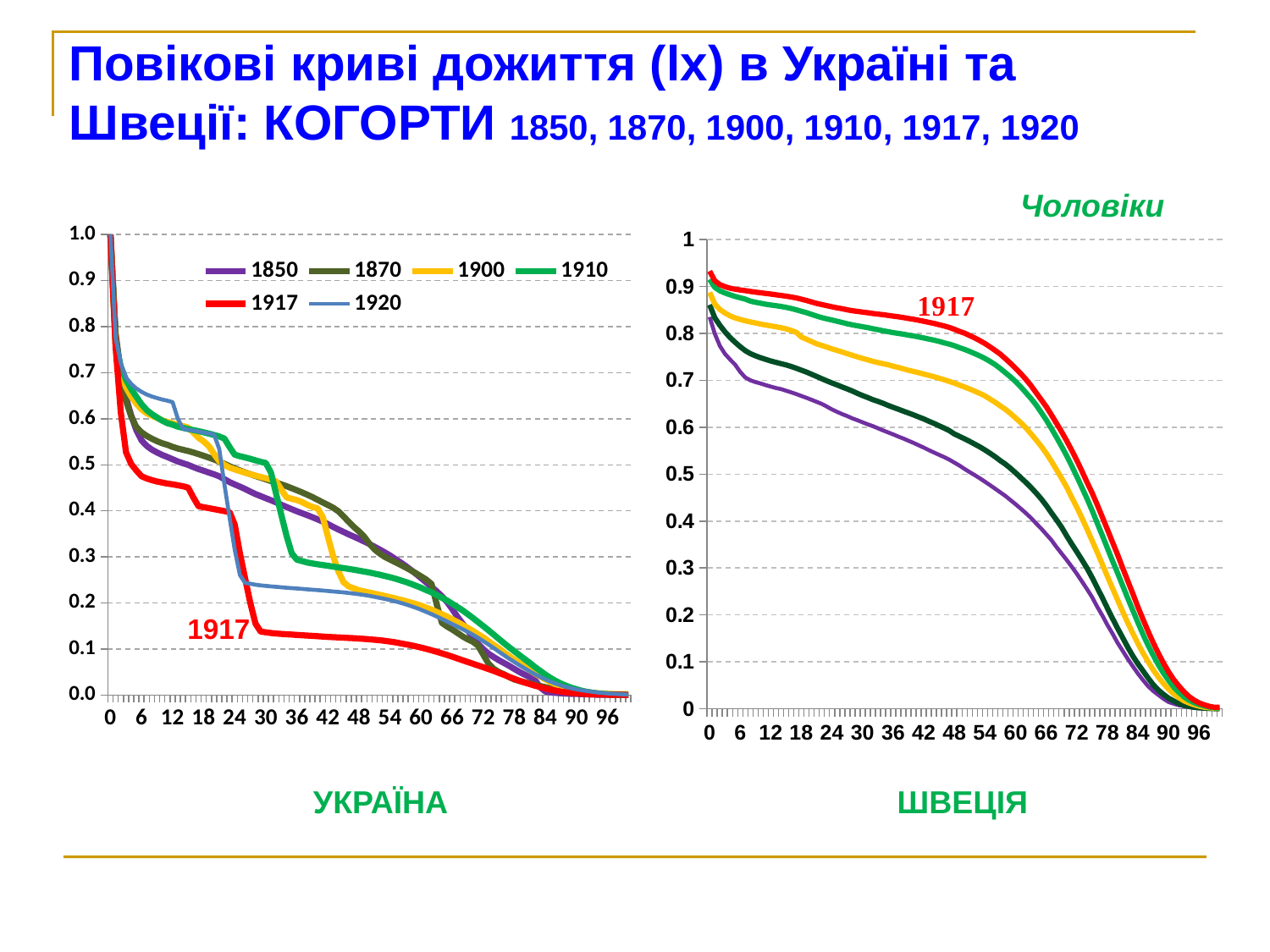
On the УКРАЇНА chart, is the value of the 1917 curve at age 6 greater or less than 0.5? less On the УКРАЇНА chart, is the value of the 1917 curve at age 30 greater or less than 0.2? less On the ШВЕЦІЯ chart, do the values of the 1917 curve rise or fall as age increases along the x axis? fall On the ШВЕЦІЯ chart, is the value of the 1917 curve at age 30 greater or less than 0.8? greater On the УКРАЇНА chart, which curve is lowest at age 30? 1917 How many series does the legend of the УКРАЇНА chart list? 6 What kind of chart is the УКРАЇНА chart on the left? line chart On the УКРАЇНА chart, at age 30, which is larger: the 1910 curve or the 1917 curve? 1910 On the УКРАЇНА chart, do the values of the 1917 curve rise or fall as age increases along the x axis? fall On the УКРАЇНА chart, what colour is the 1917 series in the legend? red On the УКРАЇНА chart, what is the value of the 1917 curve at age 0? 1.0